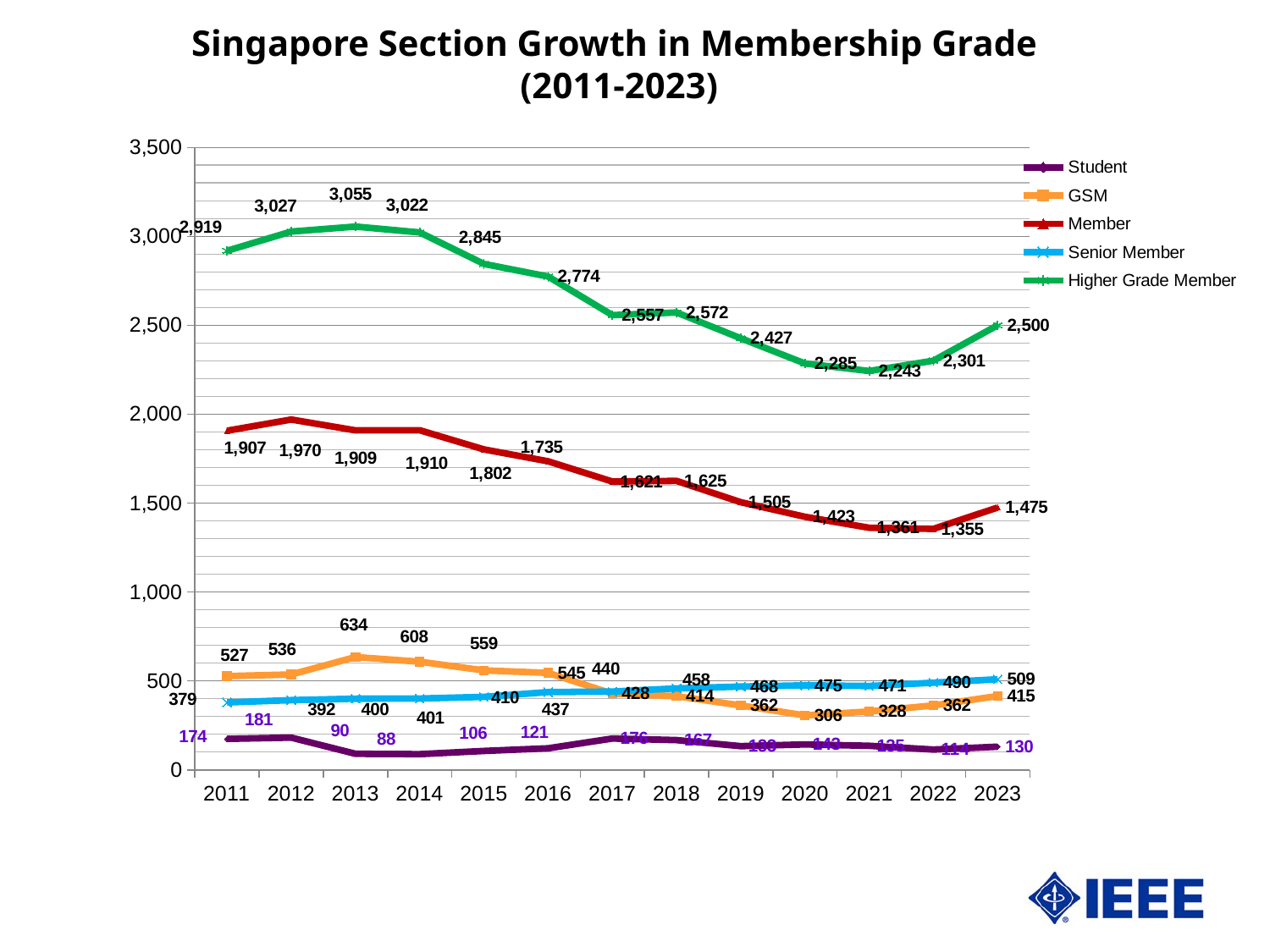
What is the Higher Grade Member value in 2013? 3,055 In which year is the Member series at its lowest value? 2022 What is the GSM value in 2013? 634 Does the Senior Member series generally rise or fall from 2011 to 2023? rise How many series does the legend list? 5 What is the Student value in 2011? 174 How many years are plotted along the x axis? 13 In which year does the Higher Grade Member series reach its highest value? 2013 What is the difference between the Member value in 2011 and in 2023? 432 Is the Higher Grade Member value in 2020 greater or less than 2,500? less What kind of chart is shown on the slide? line chart In 2023, which is larger: Senior Member or GSM? Senior Member